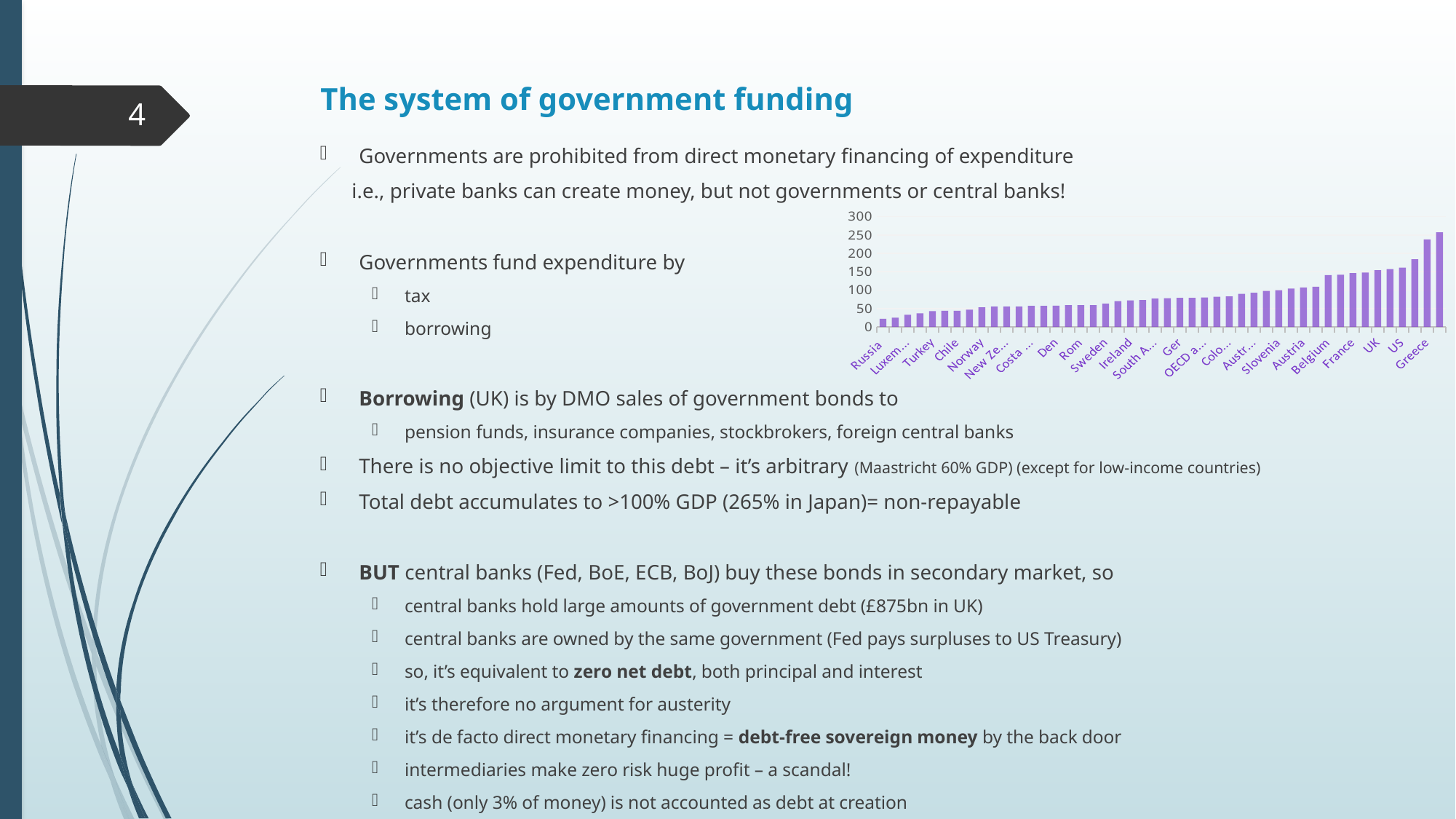
Which has the larger value, the US or the UK? US What colour are the bars in the chart? purple Is the value for Austria greater or less than 50? greater Is the value for Sweden greater or less than 100? less Do the bar values rise or fall from left to right across the chart? rise What kind of chart is shown on the slide? bar chart Which has the larger value, France or Turkey? France Is the value for Russia greater or less than 50? less Which country has the lowest bar in the chart? Russia What is the highest value shown on the vertical axis of the chart? 300